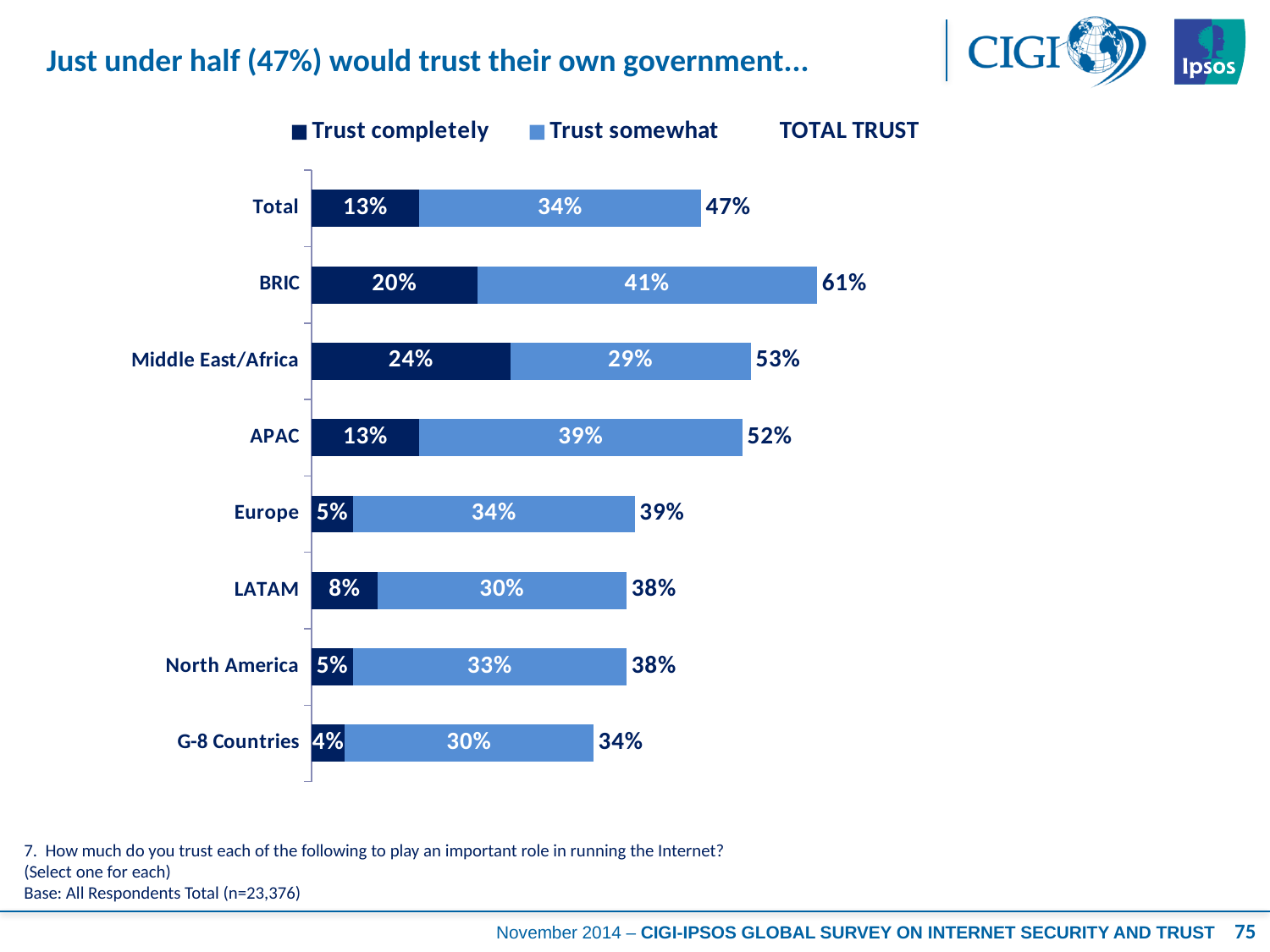
What is the difference between the TOTAL TRUST values for BRIC and G-8 Countries? 27% Which category has the highest TOTAL TRUST value? BRIC How many series does the legend list? 3 What kind of chart is shown on the slide? Stacked bar chart Which category has the lowest 'Trust completely' value? G-8 Countries What is the TOTAL TRUST value for Europe? 39% What is the total of the stacked bar for North America? 38% How many categories are shown on the chart? 8 What is the 'Trust completely' value for Middle East/Africa? 24% Which series is shown in dark navy blue? Trust completely Which has a larger 'Trust somewhat' value, APAC or LATAM? APAC What is the 'Trust somewhat' value for BRIC? 41%